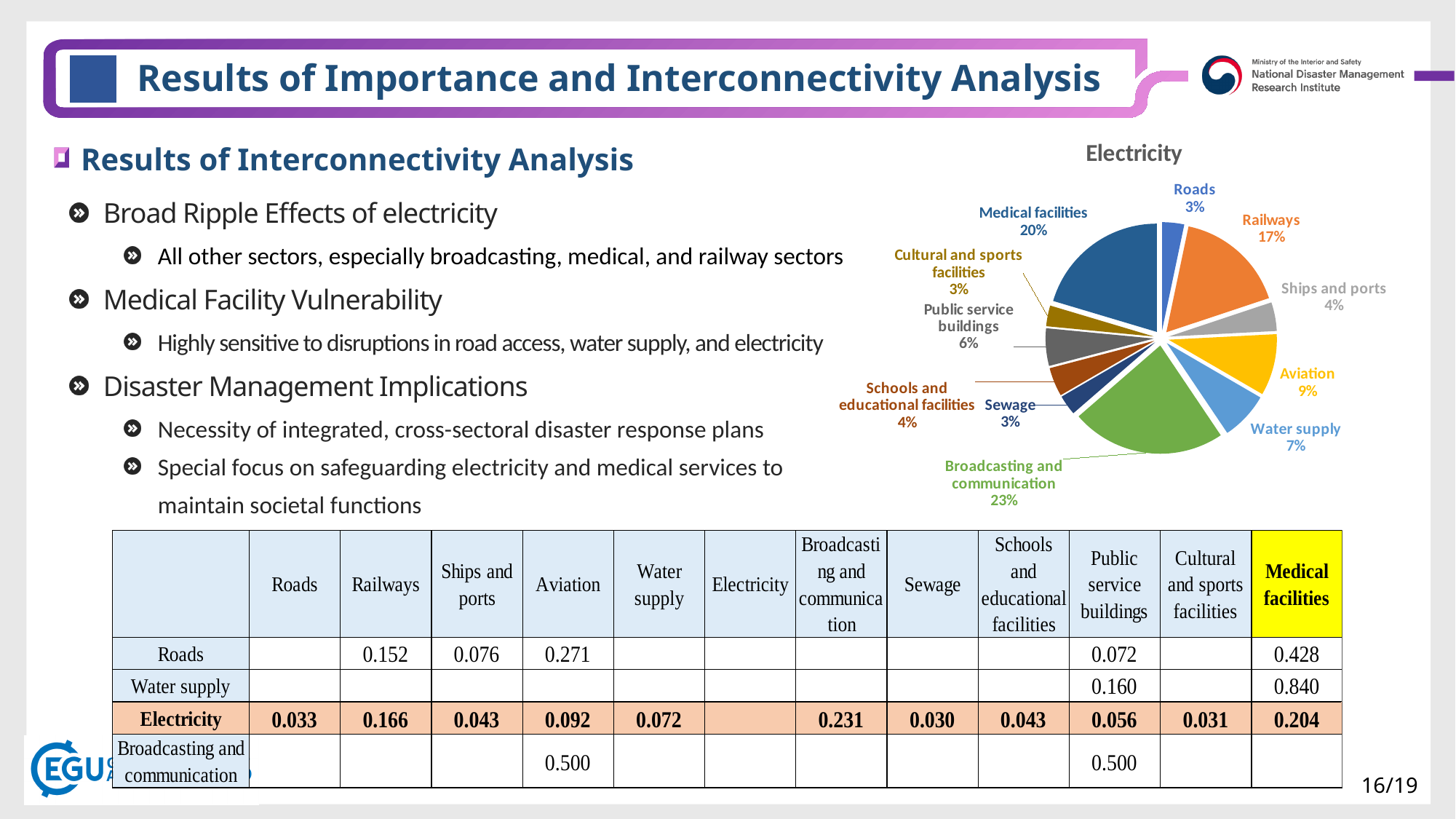
Which is larger in the pie chart, Railways or Ships and ports? Railways What share of the pie chart does Medical facilities have? 20% What is the value shown for Aviation in the pie chart? 9% What is the title of the pie chart? Electricity What is the difference in percentage points between Broadcasting and communication and Medical facilities in the pie chart? 3 What is the value shown for Public service buildings in the pie chart? 6% What is the value shown for Sewage in the pie chart? 3% Which is larger in the pie chart, Water supply or Aviation? Aviation What is the value shown for Railways in the pie chart? 17% What kind of chart is shown on the slide? pie chart How many slices does the pie chart have? 11 Which sector has the largest share in the pie chart? Broadcasting and communication